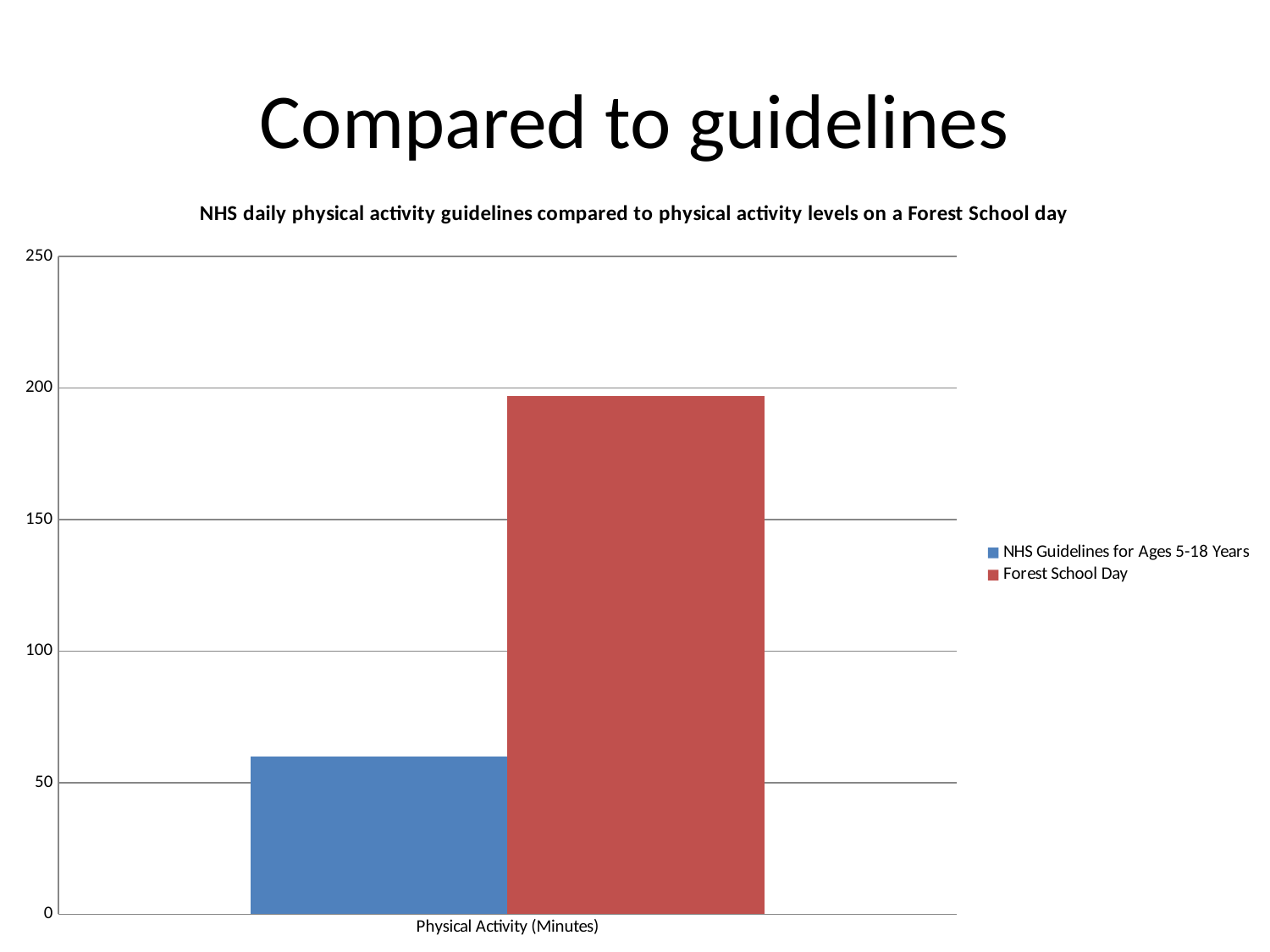
Which series has the higher value: NHS Guidelines for Ages 5-18 Years or Forest School Day? Forest School Day Is the value for NHS Guidelines for Ages 5-18 Years greater or less than 50? greater How many series does the legend list? 2 Which series has the lowest bar? NHS Guidelines for Ages 5-18 Years Which series has the highest bar? Forest School Day How many categories are shown on the x axis? 1 Is the value for Forest School Day greater or less than 150? greater What is the label on the x axis of the chart? Physical Activity (Minutes) What is the title of the chart? NHS daily physical activity guidelines compared to physical activity levels on a Forest School day What kind of chart is shown on the slide? bar chart Is the value for NHS Guidelines for Ages 5-18 Years greater or less than 100? less